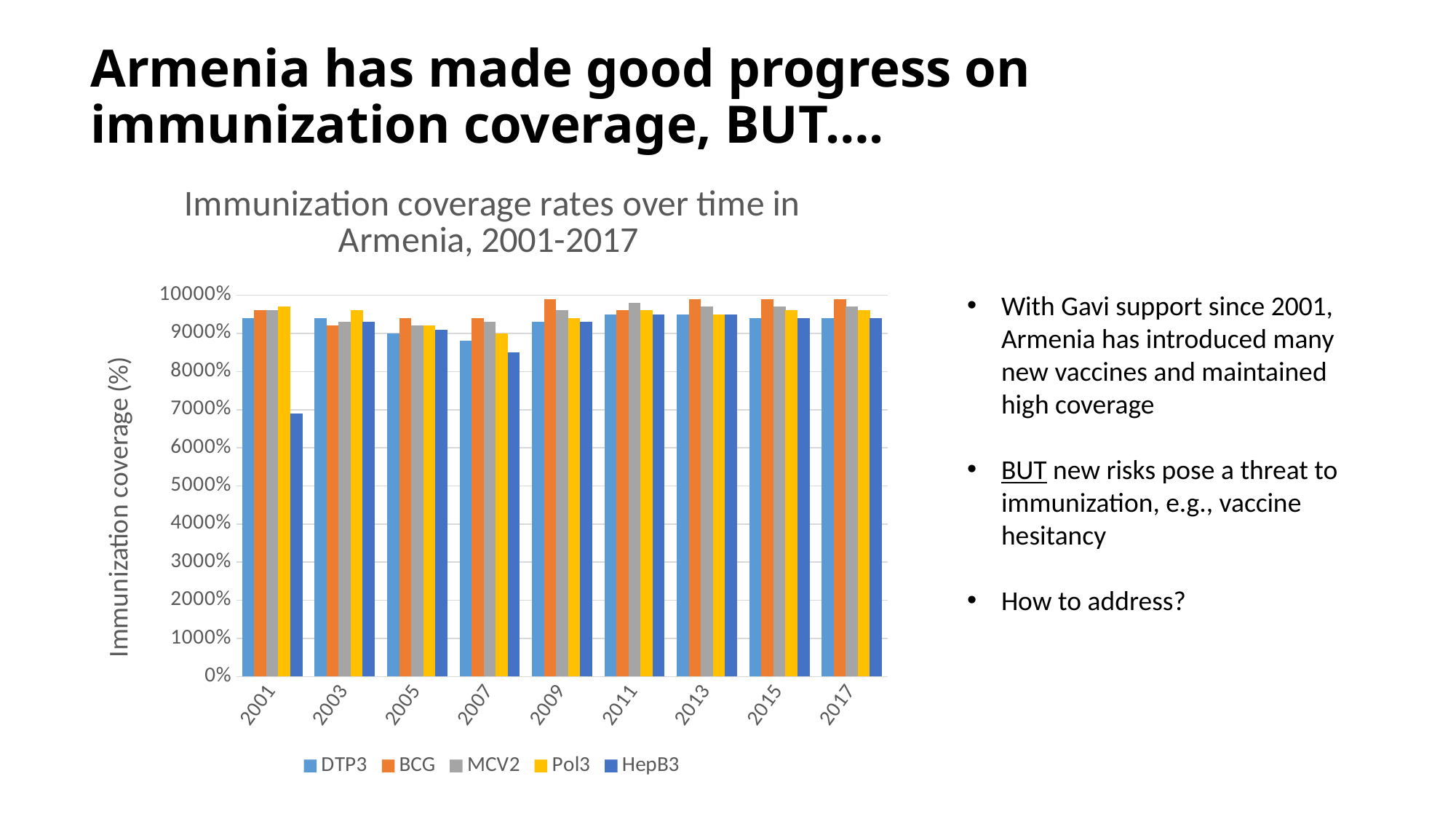
What is the label on the y axis of the chart? Immunization coverage (%) What is the title of the chart? Immunization coverage rates over time in Armenia, 2001-2017 Which series has the lowest value in 2001? HepB3 Which series has the highest value in 2009? BCG Which is larger, the HepB3 value in 2001 or the HepB3 value in 2003? 2003 Is the value for HepB3 in 2007 greater or less than 9000%? less Which series has the lowest value in 2007? HepB3 How many year categories are shown on the x axis? 9 What kind of chart is shown on the slide? bar chart Is the value for BCG in 2009 greater or less than 9000%? greater Is the value for HepB3 in 2001 greater or less than 8000%? less How many series does the legend list? 5